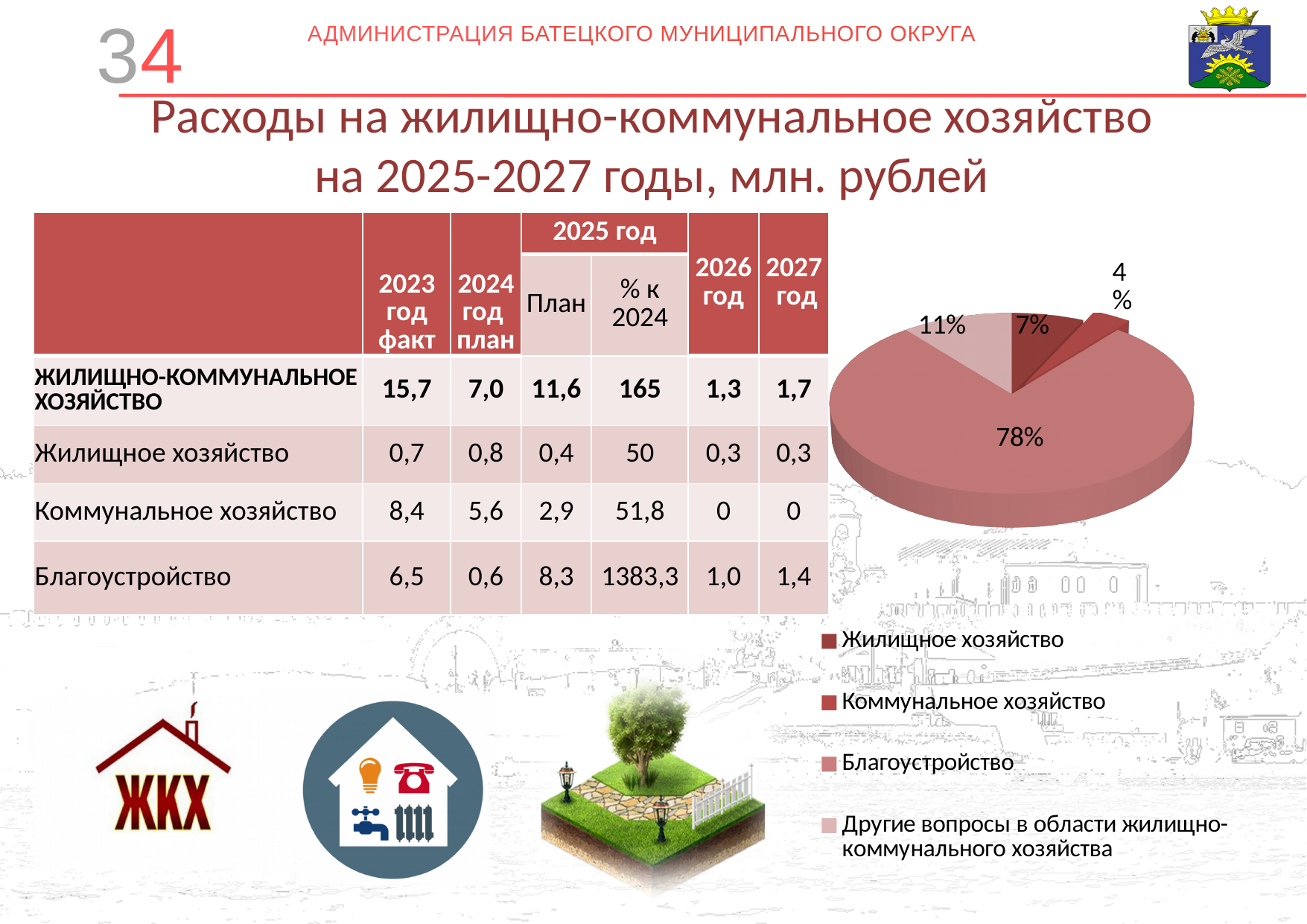
What share of the pie chart does Благоустройство take? 78% How many slices does the pie chart have? 4 What is the difference between the 78% slice and the 11% slice in the pie chart? 67 percentage points How many entries does the pie chart's legend list? 4 Is the largest slice of the pie chart greater or less than 50%? greater What is the value of the smallest slice in the pie chart? 4% What is the value of the largest slice in the pie chart? 78% Which is larger in the pie chart, the 7% slice or the 4% slice? the 7% slice What do the four percentage labels on the pie chart add up to? 100% Which legend entry of the pie chart is shown in the darkest red? Жилищное хозяйство What kind of chart is shown on the slide? pie chart What share of the pie chart does Другие вопросы в области жилищно-коммунального хозяйства take? 11%